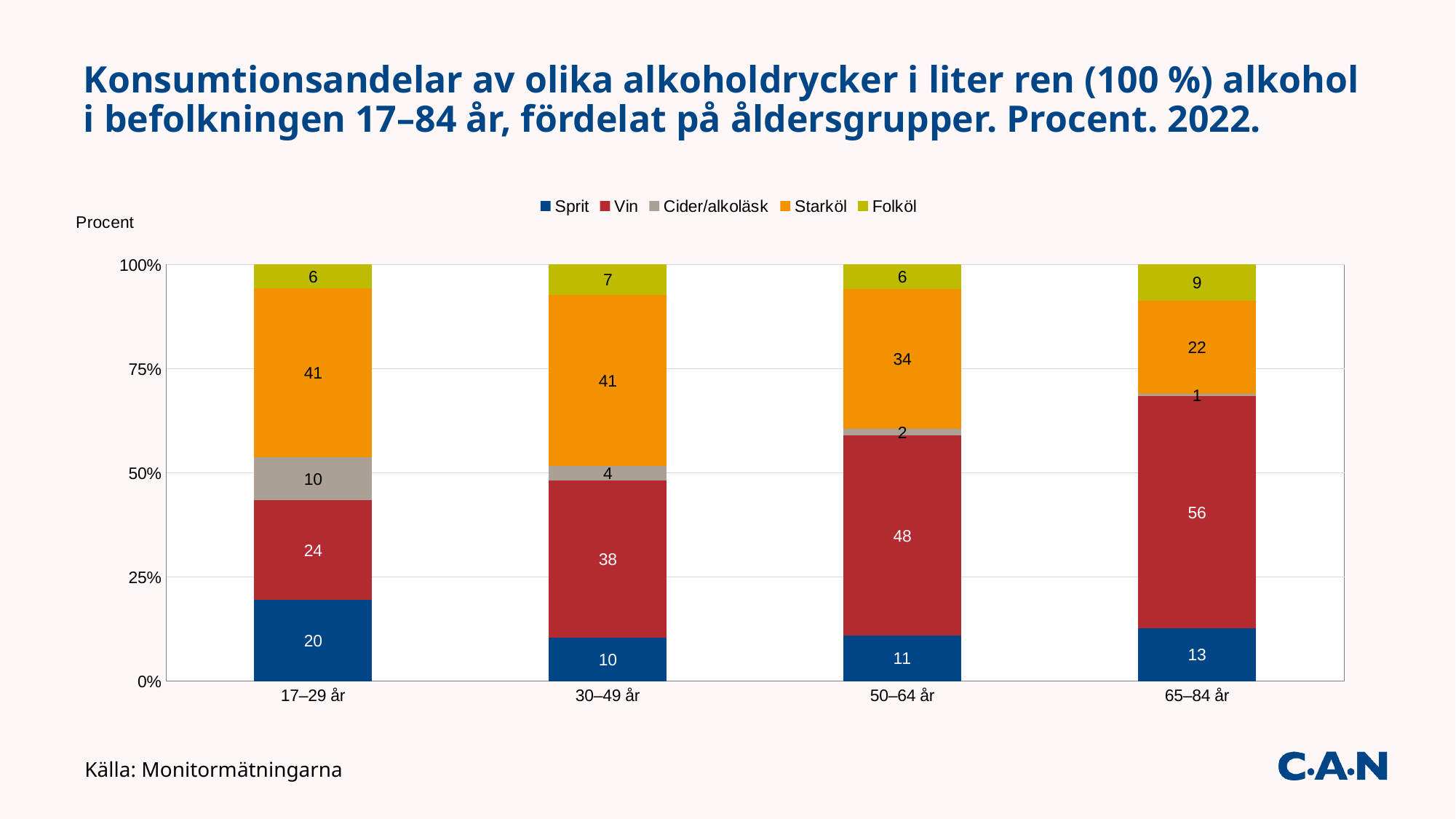
What is the value for Sprit in the 17–29 år group? 20 What is the difference between the Vin values for 50–64 år and 17–29 år? 24 What is the value for Vin in the 65–84 år group? 56 Which age group has the lowest value for Starköl? 65–84 år Does the Vin value rise or fall across the age groups from 17–29 år to 65–84 år? Rise What is the value for Starköl in the 50–64 år group? 34 Which is larger, the Folköl value for 65–84 år or for 30–49 år? 65–84 år How many age groups are shown on the x axis? 4 Which age group has the highest value for Vin? 65–84 år What kind of chart is shown on the slide? Stacked bar chart How many series does the legend list? 5 What is the value for Cider/alkoläsk in the 30–49 år group? 4